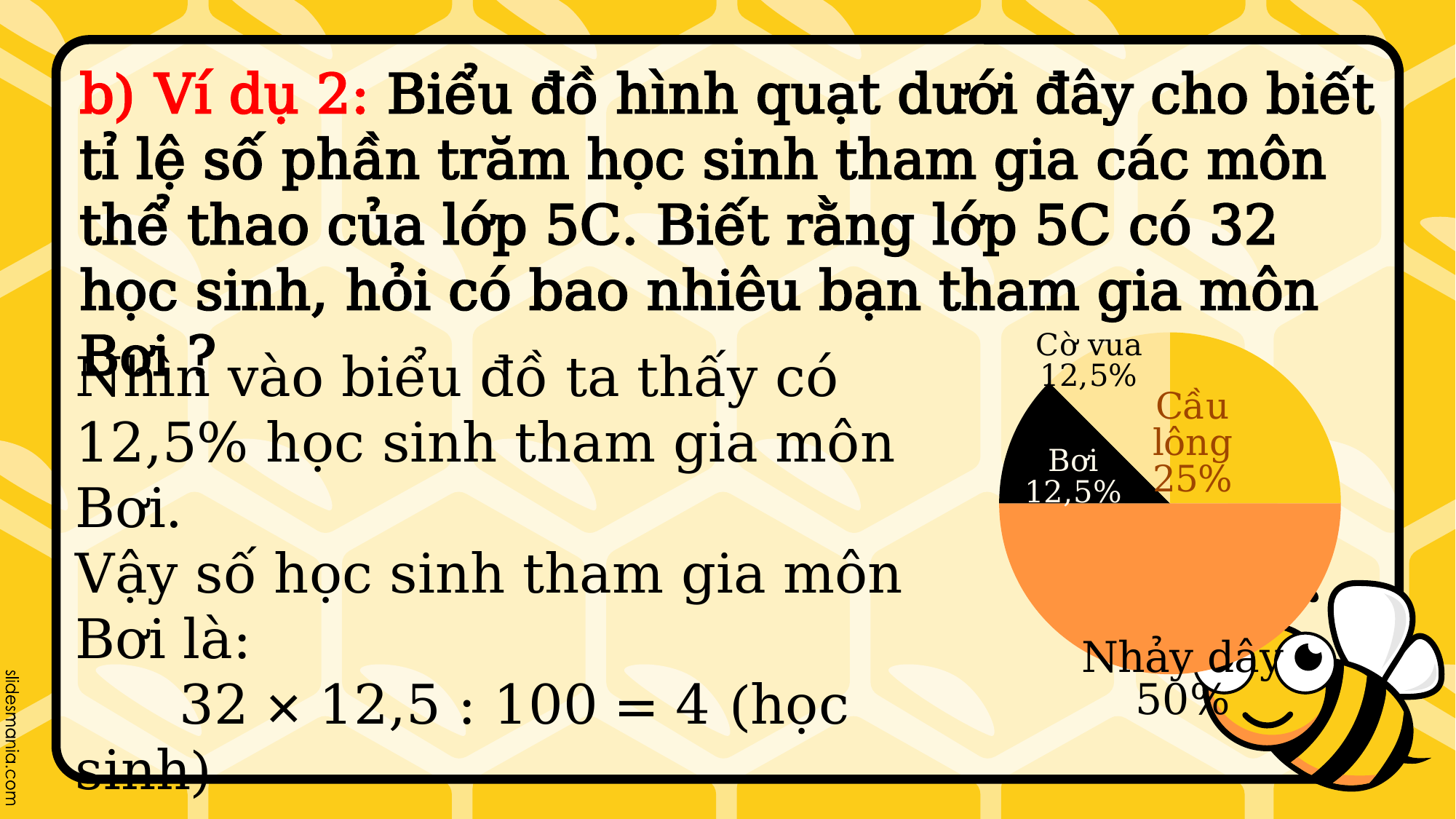
What kind of chart is shown on the slide? pie chart Which slice of the pie chart is the largest? Nhảy dây What percentage of the pie chart is labelled Cờ vua? 12,5% What is the difference between the Cầu lông share and the Cờ vua share in the pie chart? 12,5% What percentage of the pie chart is labelled Bơi? 12,5% Which is larger in the pie chart, Cầu lông or Bơi? Cầu lông What colour is the Bơi slice in the pie chart? black What is the combined share of Bơi and Cờ vua in the pie chart? 25% What is the difference between the Nhảy dây share and the Cầu lông share in the pie chart? 25% What percentage of the pie chart is labelled Cầu lông? 25% What percentage of the pie chart is labelled Nhảy dây? 50% How many slices does the pie chart have? 4